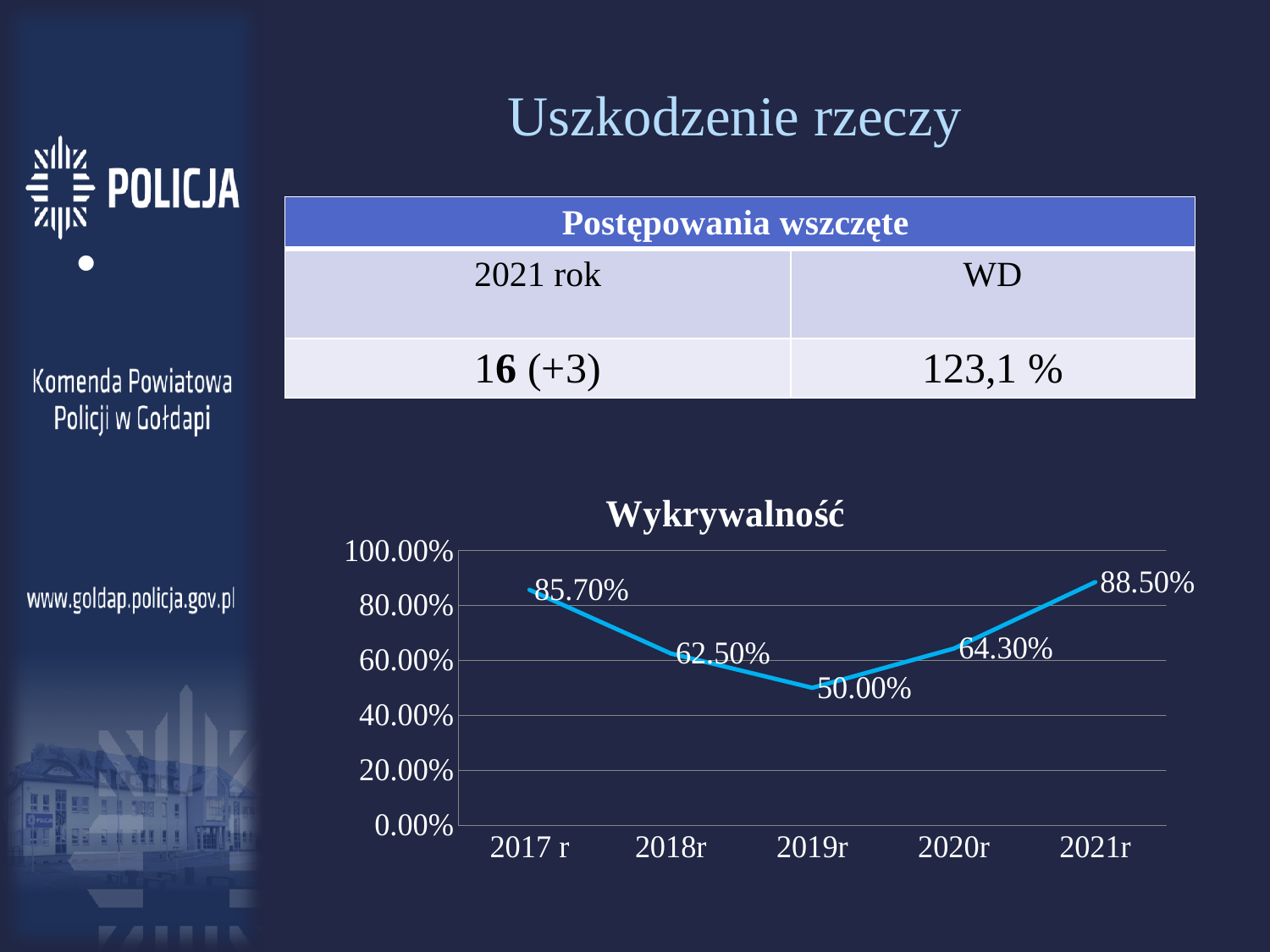
What is the difference between the 2021r and 2017 r values in the Wykrywalność chart? 2.80% Which is larger in the Wykrywalność chart, the value for 2018r or the value for 2020r? 2020r What kind of chart is the Wykrywalność chart? line chart Which year has the lowest value in the Wykrywalność chart? 2019r What is the value for 2019r in the Wykrywalność chart? 50.00% Which year has the highest value in the Wykrywalność chart? 2021r Is the value for 2018r in the Wykrywalność chart greater or less than 60.00%? greater What is the value for 2021r in the Wykrywalność chart? 88.50% What is the value for 2017 r in the Wykrywalność chart? 85.70% Does the value in the Wykrywalność chart rise or fall from 2017 r to 2019r? fall How many years are plotted in the Wykrywalność chart? 5 What is the difference between the 2020r and 2019r values in the Wykrywalność chart? 14.30%